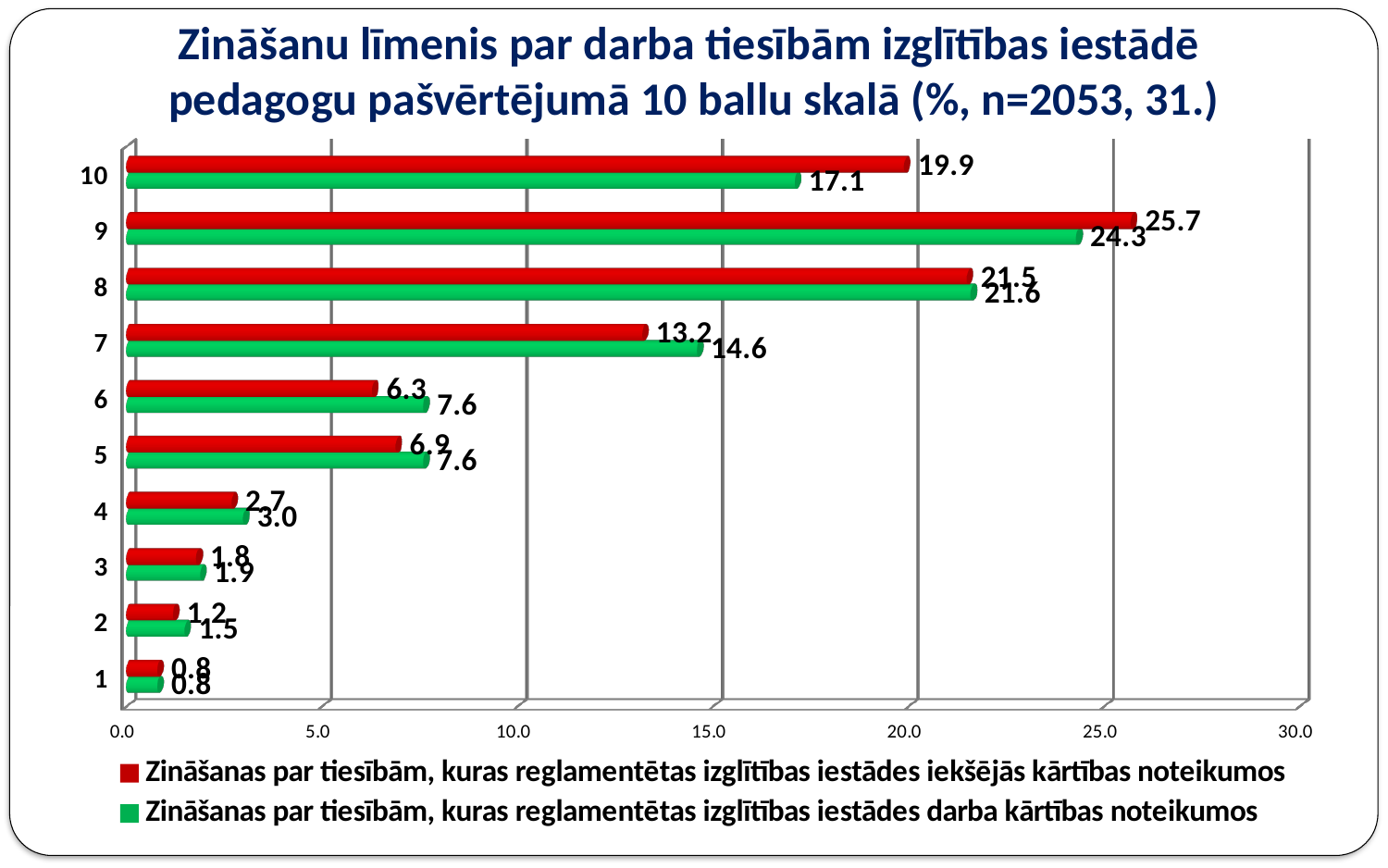
For category 9, what is the difference between the 'iekšējās kārtības noteikumos' series and the 'darba kārtības noteikumos' series? 1.4 Is the value for category 6 in the series 'Zināšanas par tiesībām, kuras reglamentētas izglītības iestādes iekšējās kārtības noteikumos' greater or less than 10.0? less How many categories (scale points) are shown on the vertical axis? 10 What is the value for category 9 in the series 'Zināšanas par tiesībām, kuras reglamentētas izglītības iestādes iekšējās kārtības noteikumos'? 25.7 What is the value for category 7 in the series 'Zināšanas par tiesībām, kuras reglamentētas izglītības iestādes darba kārtības noteikumos'? 14.6 Which category has the highest value in the series 'Zināšanas par tiesībām, kuras reglamentētas izglītības iestādes iekšējās kārtības noteikumos'? 9 What is the value for category 10 in the series 'Zināšanas par tiesībām, kuras reglamentētas izglītības iestādes darba kārtības noteikumos'? 17.1 Which category has the lowest value in the series 'Zināšanas par tiesībām, kuras reglamentētas izglītības iestādes darba kārtības noteikumos'? 1 How many series does the legend list? 2 What colour represents the series 'Zināšanas par tiesībām, kuras reglamentētas izglītības iestādes iekšējās kārtības noteikumos'? red What kind of chart is shown on the slide? bar chart For category 7, which series has the larger value? Zināšanas par tiesībām, kuras reglamentētas izglītības iestādes darba kārtības noteikumos